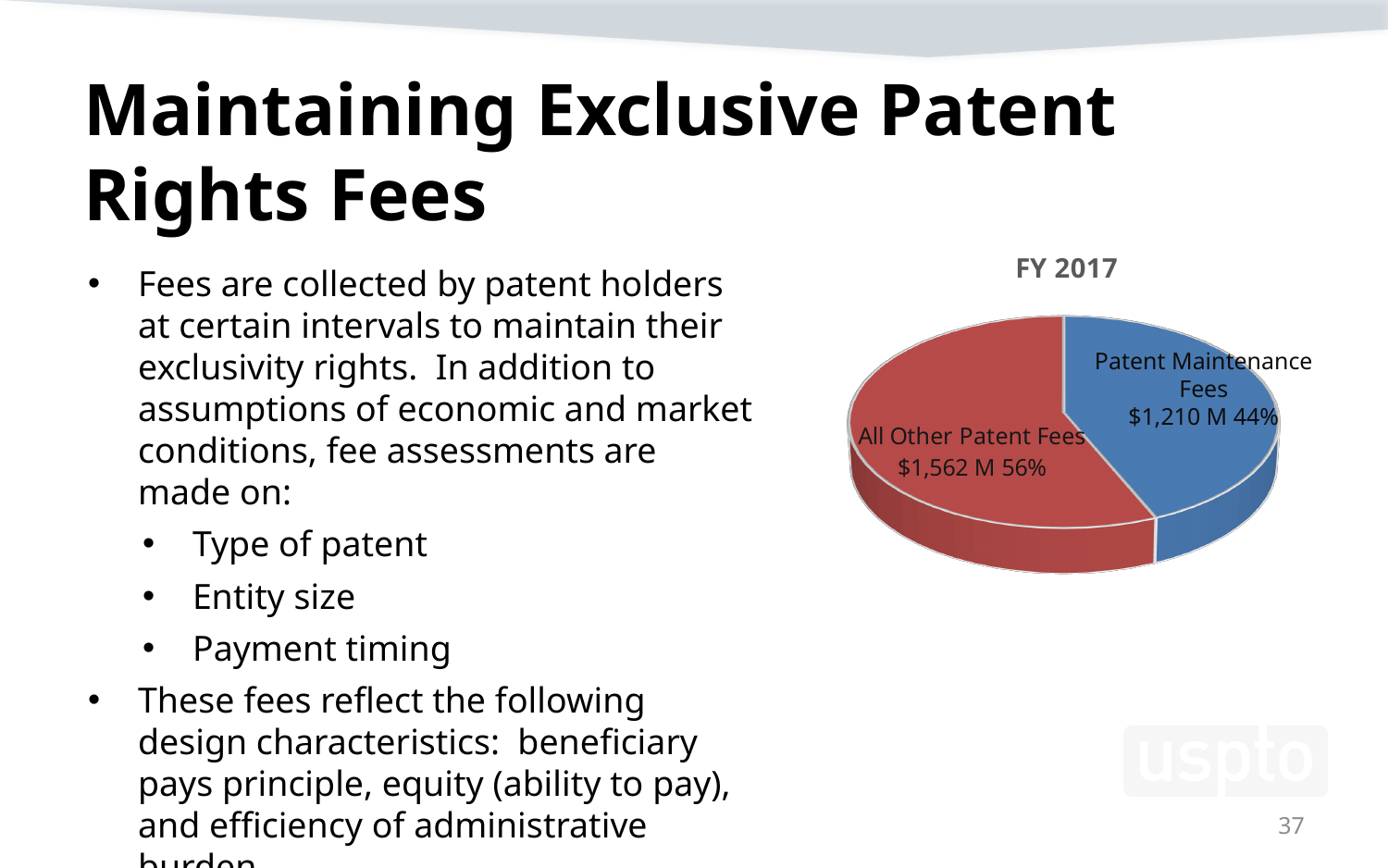
What is the value for Patent Maintenance Fees? $1,210 M What type of chart is shown on the slide? pie chart What share of the pie is All Other Patent Fees? 56% Which slice is the smallest? Patent Maintenance Fees What colour is the Patent Maintenance Fees slice? blue What is the value for All Other Patent Fees? $1,562 M What share of the pie is Patent Maintenance Fees? 44% What is the title of the chart? FY 2017 How many slices does the pie chart have? 2 Which slice is the largest? All Other Patent Fees Which is larger, Patent Maintenance Fees or All Other Patent Fees? All Other Patent Fees What is the difference in value between All Other Patent Fees and Patent Maintenance Fees? $352 M